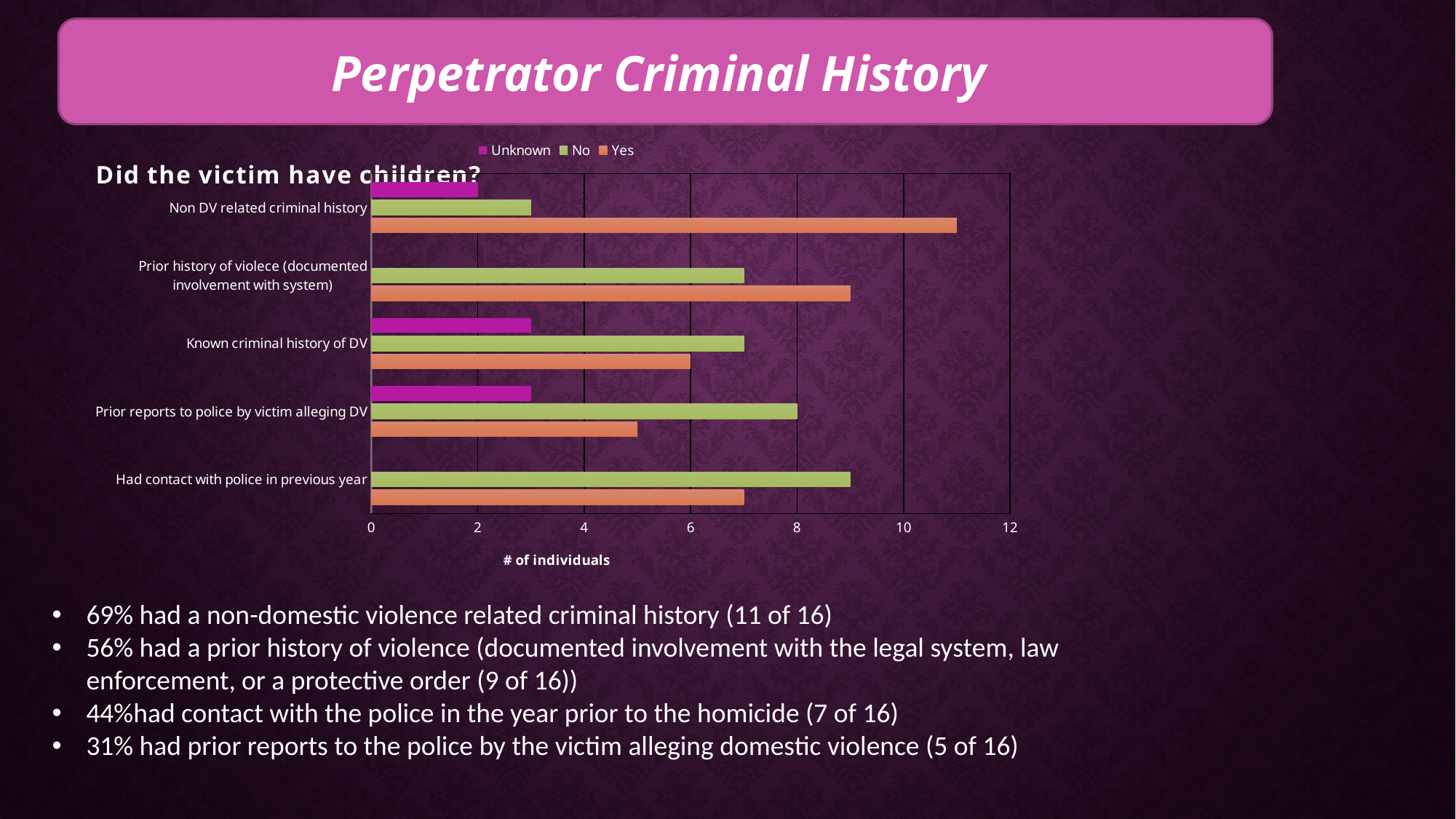
Which is larger: the Yes value for Non DV related criminal history or the Yes value for Known criminal history of DV? Non DV related criminal history What is the No value for Prior reports to police by victim alleging DV? 8 Which category has the longest Yes bar? Non DV related criminal history Is the No value for Had contact with police in previous year greater or less than 8? greater What kind of chart is shown on the slide? bar chart What is the Unknown value for Non DV related criminal history? 2 What is the title of the horizontal axis? # of individuals Is the Yes value for Prior reports to police by victim alleging DV greater or less than 6? less How many series does the chart legend list? 3 Is the Yes value for Non DV related criminal history greater or less than 10? greater How many categories are plotted on the chart? 5 What is the Yes value for Known criminal history of DV? 6